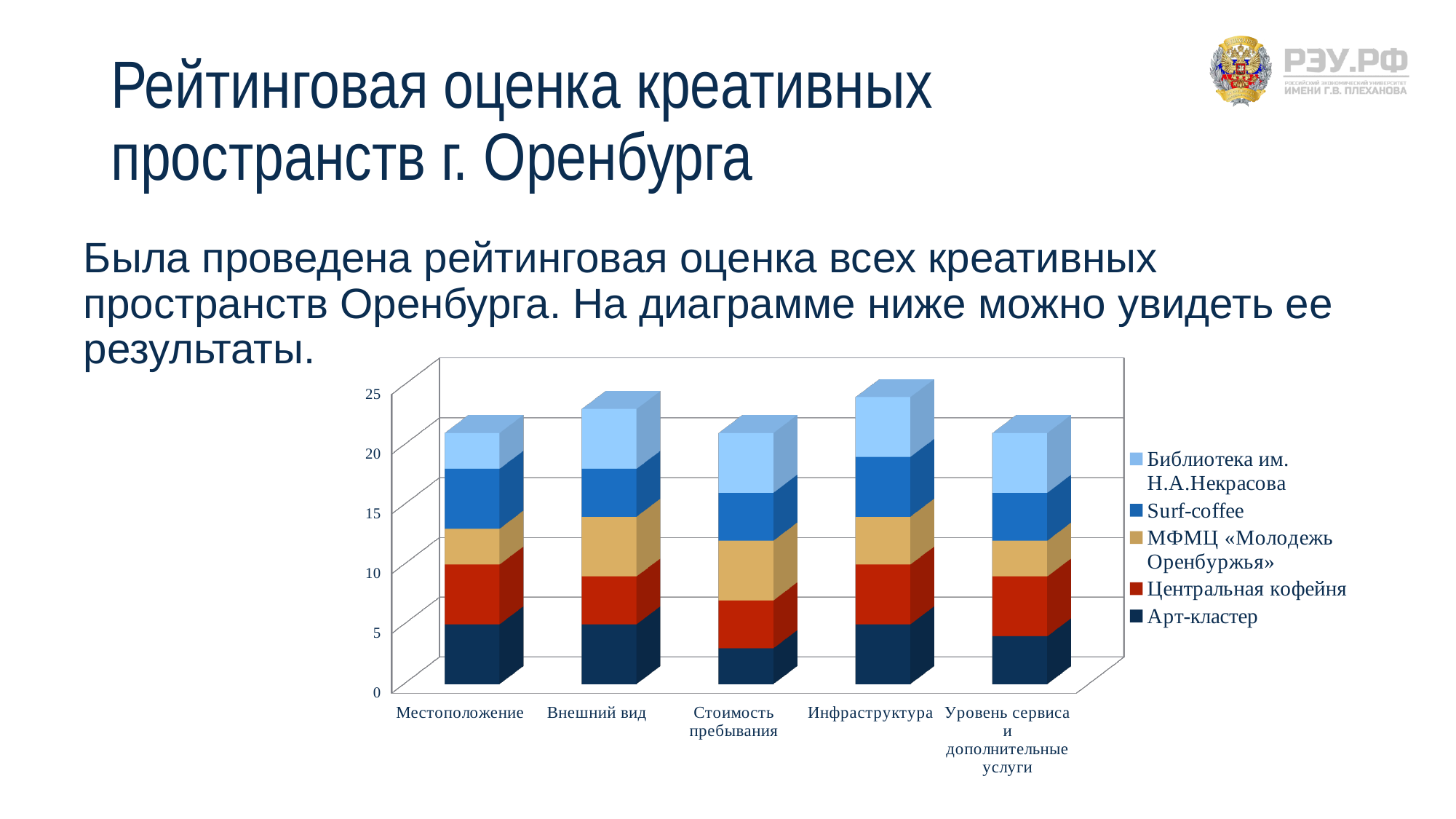
How many series does the chart's legend list? 5 Which has the larger Арт-кластер segment: Стоимость пребывания or Инфраструктура? Инфраструктура Which category has the highest total stacked bar? Инфраструктура Which has the larger total stacked bar: Инфраструктура or Стоимость пребывания? Инфраструктура Which series is shown in the lightest blue colour in the legend? Библиотека им. Н.А.Некрасова Is the total stacked value for Внешний вид greater or less than 20? greater Is the total stacked value for Инфраструктура greater or less than 20? greater Is the total stacked value for Местоположение greater or less than 15? greater How many categories are shown along the x axis of the chart? 5 What kind of chart is shown on the slide? Stacked bar chart Which series is shown at the bottom of each stacked bar? Арт-кластер